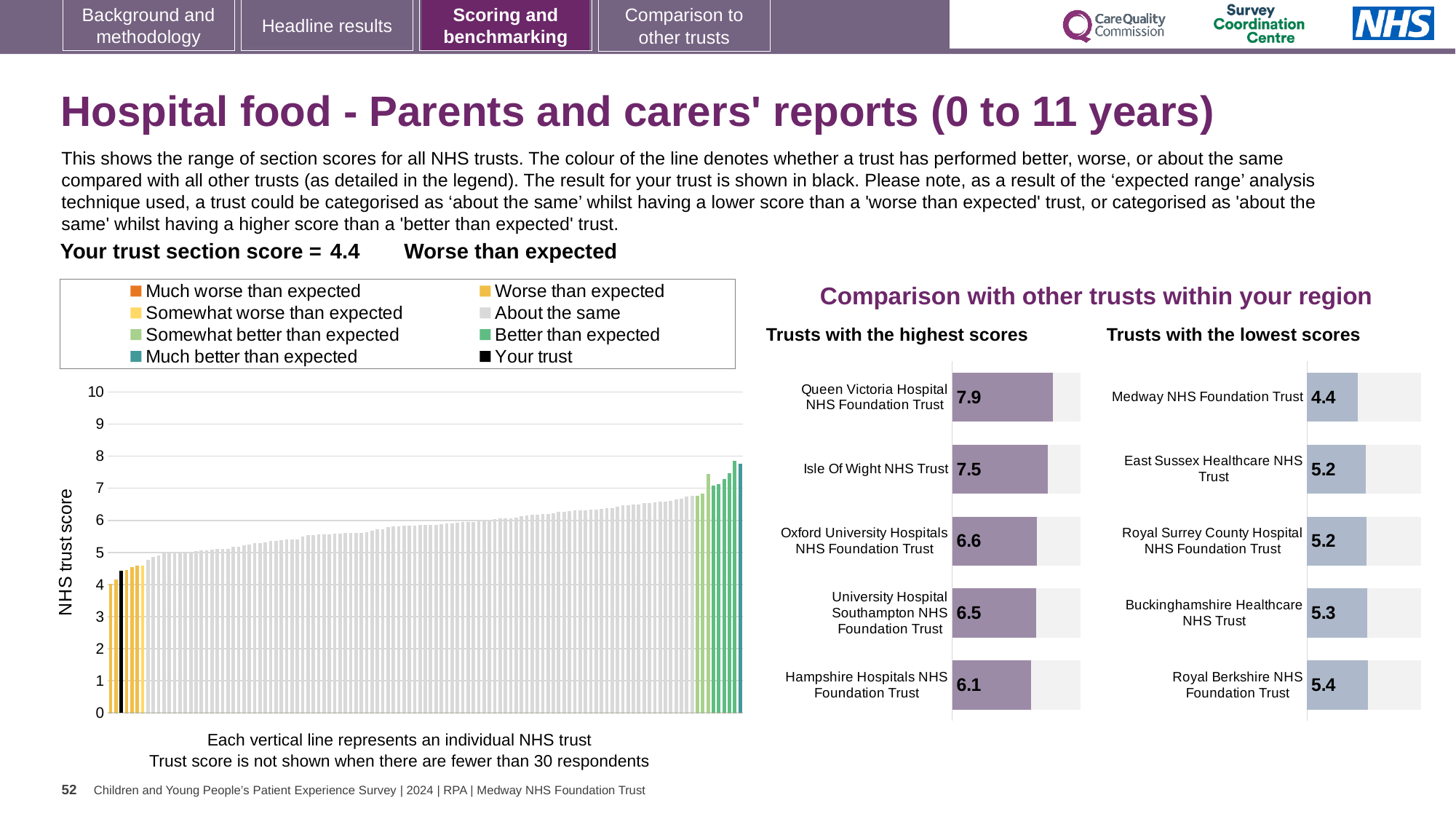
In the 'Trusts with the lowest scores' chart, what is the difference between the scores of Royal Berkshire NHS Foundation Trust and Medway NHS Foundation Trust? 1.0 In the 'Trusts with the highest scores' chart, what is the score for Hampshire Hospitals NHS Foundation Trust? 6.1 In the 'Trusts with the lowest scores' chart, what is the score for Medway NHS Foundation Trust? 4.4 How many entries does the legend of the main 'NHS trust score' chart on the left list? 8 In the 'Trusts with the lowest scores' chart, which trust has the highest score shown? Royal Berkshire NHS Foundation Trust How many trusts are listed in the 'Trusts with the lowest scores' chart? 5 In the main 'NHS trust score' chart on the left, do the trust scores rise or fall from left to right? rise In the 'Trusts with the highest scores' chart, which trust has the lowest score shown? Hampshire Hospitals NHS Foundation Trust In the 'Trusts with the highest scores' chart, what is the score for Queen Victoria Hospital NHS Foundation Trust? 7.9 In the main 'NHS trust score' chart on the left, is the value for the black 'Your trust' bar greater or less than 5? less In the 'Trusts with the highest scores' chart, what is the difference between the scores of Queen Victoria Hospital NHS Foundation Trust and Isle Of Wight NHS Trust? 0.4 In the 'Trusts with the highest scores' chart, which has the larger score: Oxford University Hospitals NHS Foundation Trust or University Hospital Southampton NHS Foundation Trust? Oxford University Hospitals NHS Foundation Trust